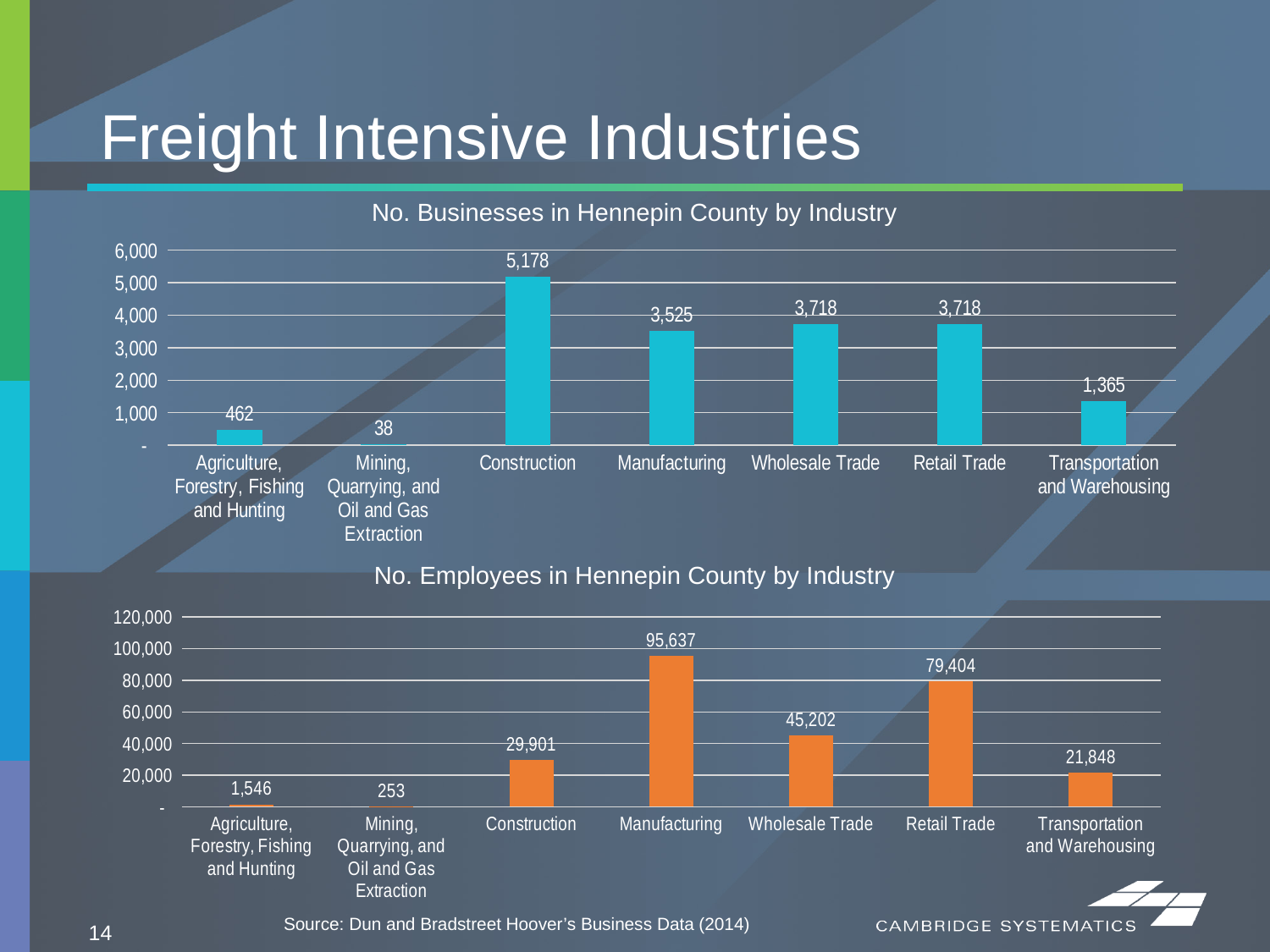
In the 'No. Employees in Hennepin County by Industry' chart, what is the difference between Retail Trade and Wholesale Trade? 34,202 What is the title of the top chart on the slide? No. Businesses in Hennepin County by Industry In the 'No. Employees in Hennepin County by Industry' chart, which industry has the highest number of employees? Manufacturing In the 'No. Employees in Hennepin County by Industry' chart, which is larger: Wholesale Trade or Retail Trade? Retail Trade In the 'No. Businesses in Hennepin County by Industry' chart, which industry has the lowest number of businesses? Mining, Quarrying, and Oil and Gas Extraction In the 'No. Employees in Hennepin County by Industry' chart, what is the value for Mining, Quarrying, and Oil and Gas Extraction? 253 In the 'No. Businesses in Hennepin County by Industry' chart, how many industries are shown? 7 In the 'No. Businesses in Hennepin County by Industry' chart, what is the value for Construction? 5,178 What type of chart is the 'No. Employees in Hennepin County by Industry' chart? Bar chart In the 'No. Employees in Hennepin County by Industry' chart, what is the value for Manufacturing? 95,637 In the 'No. Businesses in Hennepin County by Industry' chart, what is the difference between Construction and Manufacturing? 1,653 In the 'No. Businesses in Hennepin County by Industry' chart, what is the value for Transportation and Warehousing? 1,365